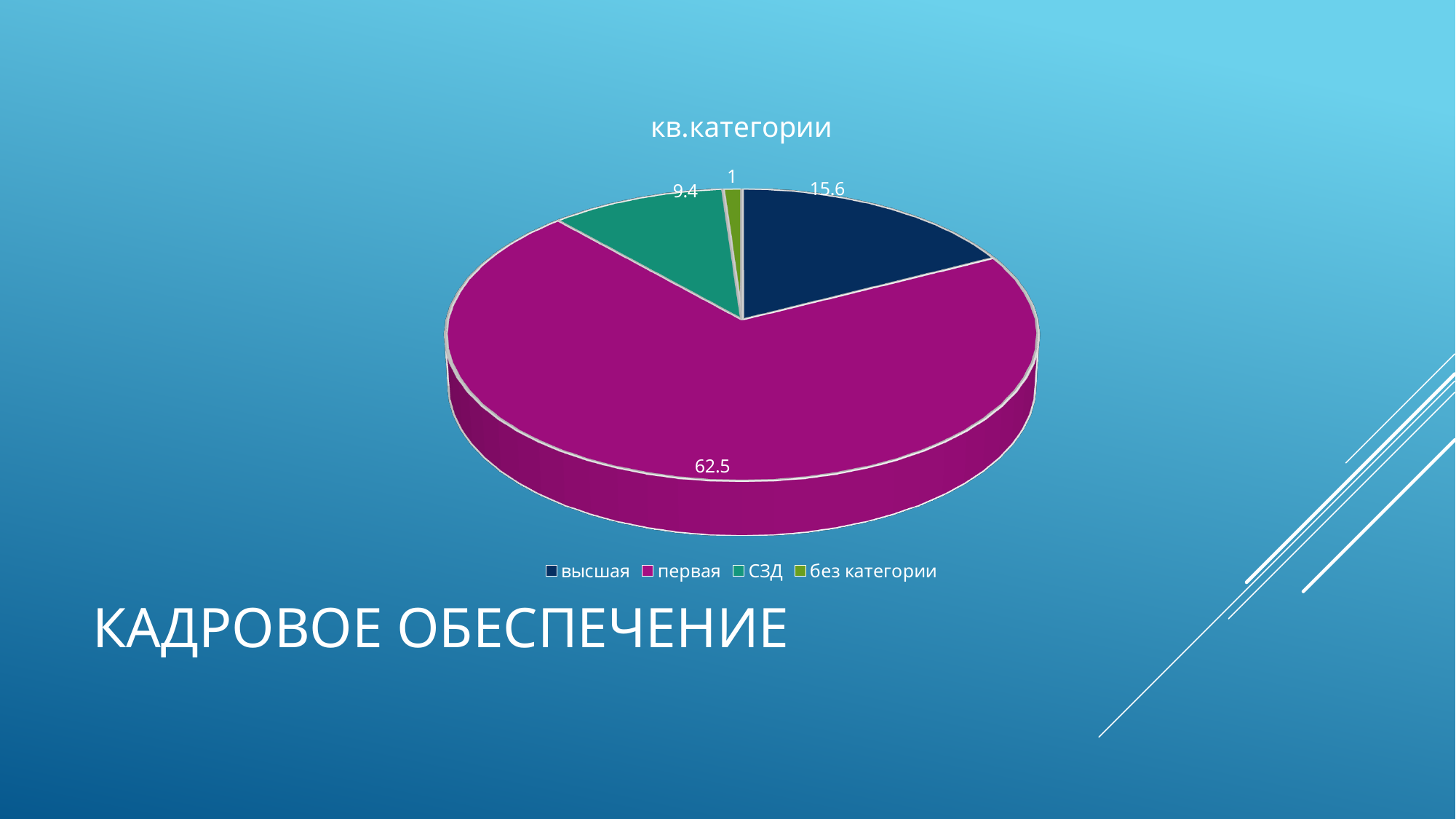
Which is larger, the value for 'высшая' or the value for 'СЗД'? высшая Which category has the smallest slice? без категории What is the value for the 'СЗД' slice? 9.4 What type of chart is shown on the slide? pie chart What is the value for the 'без категории' slice? 1 What is the value for the 'первая' slice? 62.5 What is the difference between the values for 'первая' and 'высшая'? 46.9 What is the value for the 'высшая' slice? 15.6 How many slices does the pie chart have? 4 What is the title of the chart? кв.категории Which category has the largest slice? первая How many entries does the legend list? 4